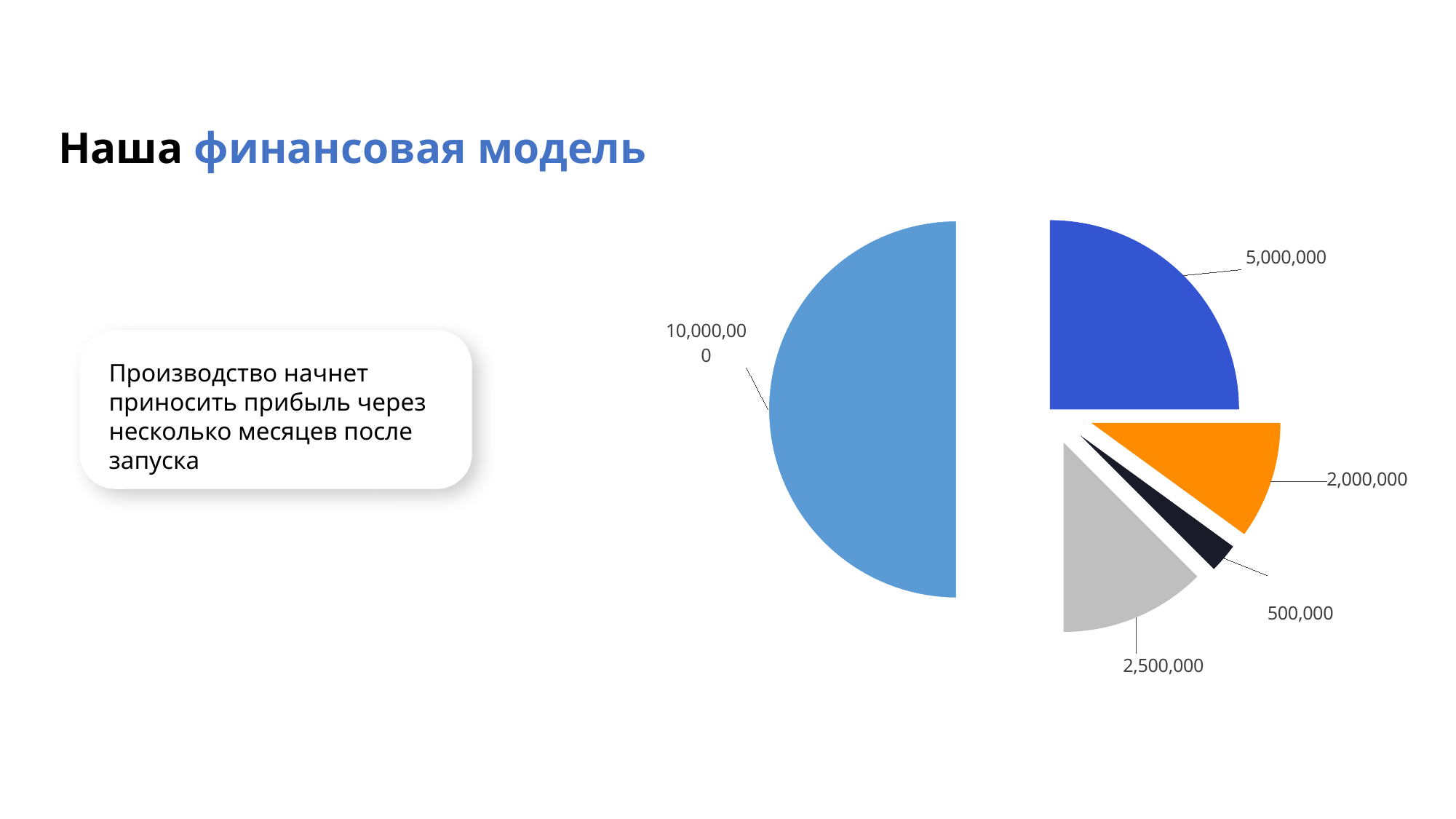
What is the value of the smallest slice of the pie chart? 500,000 What share of the whole pie does the 10,000,000 slice represent? 50% Which slice is larger, the orange one or the grey one? the grey one (2,500,000) What is the total of all the slice values in the pie chart? 20,000,000 What kind of chart is shown on the slide? pie chart How many slices does the pie chart have? 5 What value is labelled on the dark blue slice of the pie chart? 5,000,000 What value is labelled on the light blue slice of the pie chart? 10,000,000 What is the value of the largest slice of the pie chart? 10,000,000 What value is labelled on the grey slice of the pie chart? 2,500,000 What value is labelled on the orange slice of the pie chart? 2,000,000 What is the difference between the 10,000,000 slice and the 5,000,000 slice? 5,000,000